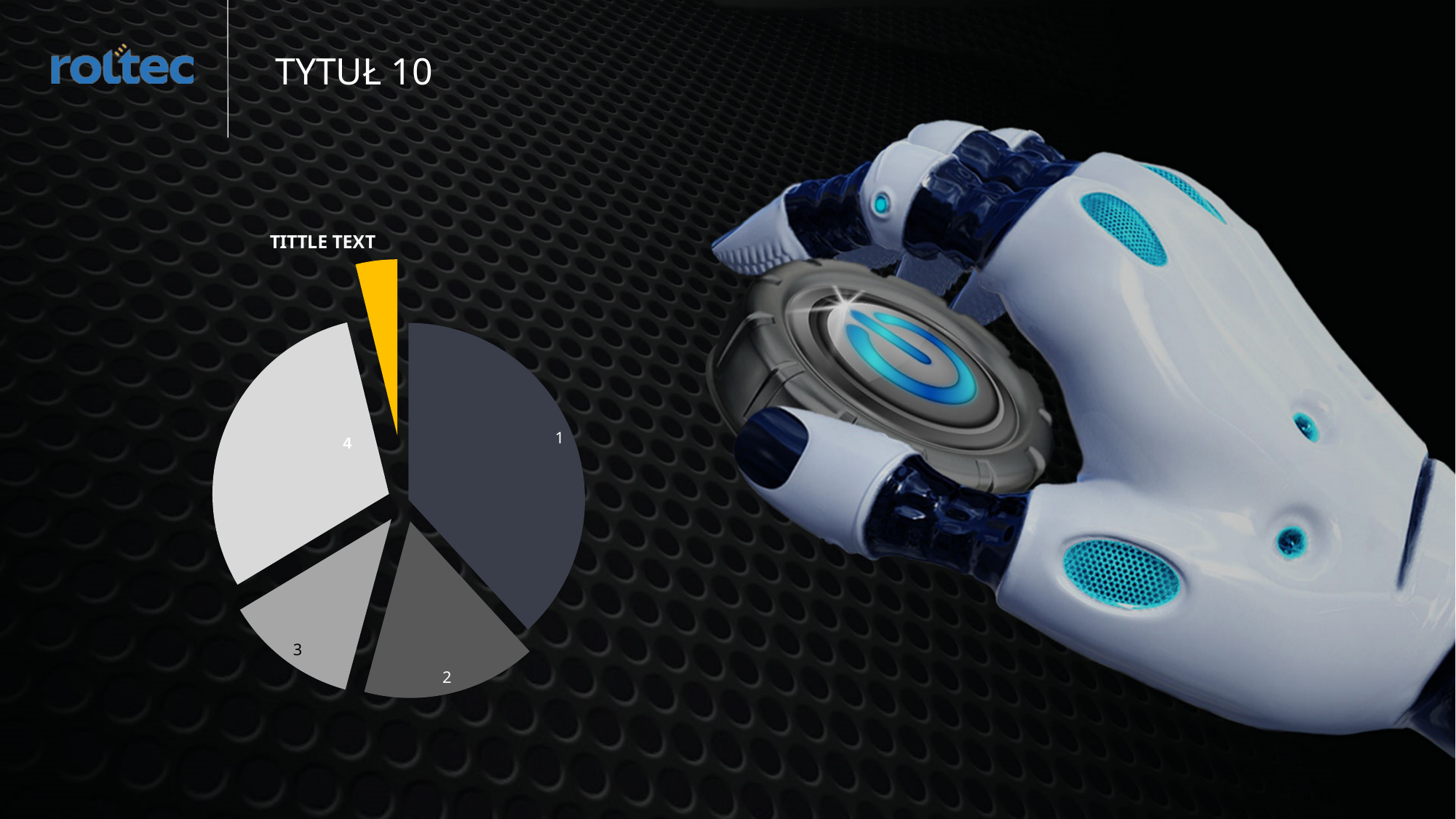
Which is larger in the pie chart, slice 4 or slice 2? 4 Which is larger in the pie chart, slice 4 or slice 3? 4 What is the title shown above the pie chart? TITTLE TEXT Which is larger in the pie chart, slice 1 or slice 3? 1 Which slice of the pie chart is the smallest? the yellow slice What kind of chart is shown on the slide? pie chart Which labelled slice of the pie chart is the largest? 1 What colour is the smallest, pulled-out slice of the pie chart? yellow How many slices does the pie chart have? 5